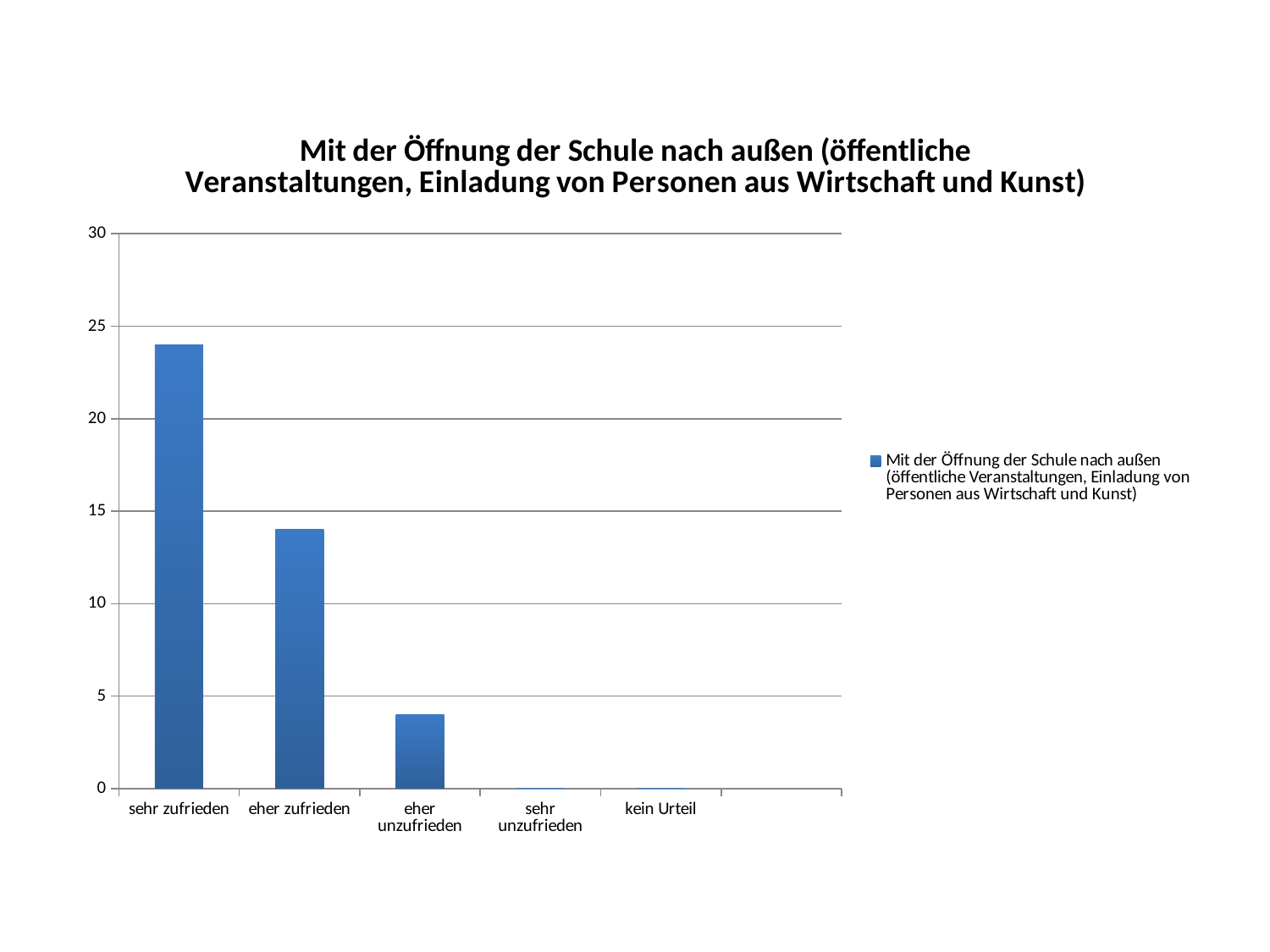
Is the value for eher zufrieden greater or less than 10? greater Is the value for eher zufrieden greater or less than 15? less Is the value for sehr zufrieden greater or less than 25? less How many categories have a visible bar above zero? 3 Which is larger, the value for eher zufrieden or the value for eher unzufrieden? eher zufrieden Do the bar values rise or fall from sehr zufrieden to eher unzufrieden along the x axis? fall Which is larger, the value for sehr zufrieden or the value for eher zufrieden? sehr zufrieden How many series does the legend list? 1 Which category has the highest bar? sehr zufrieden What kind of chart is shown on the slide? bar chart